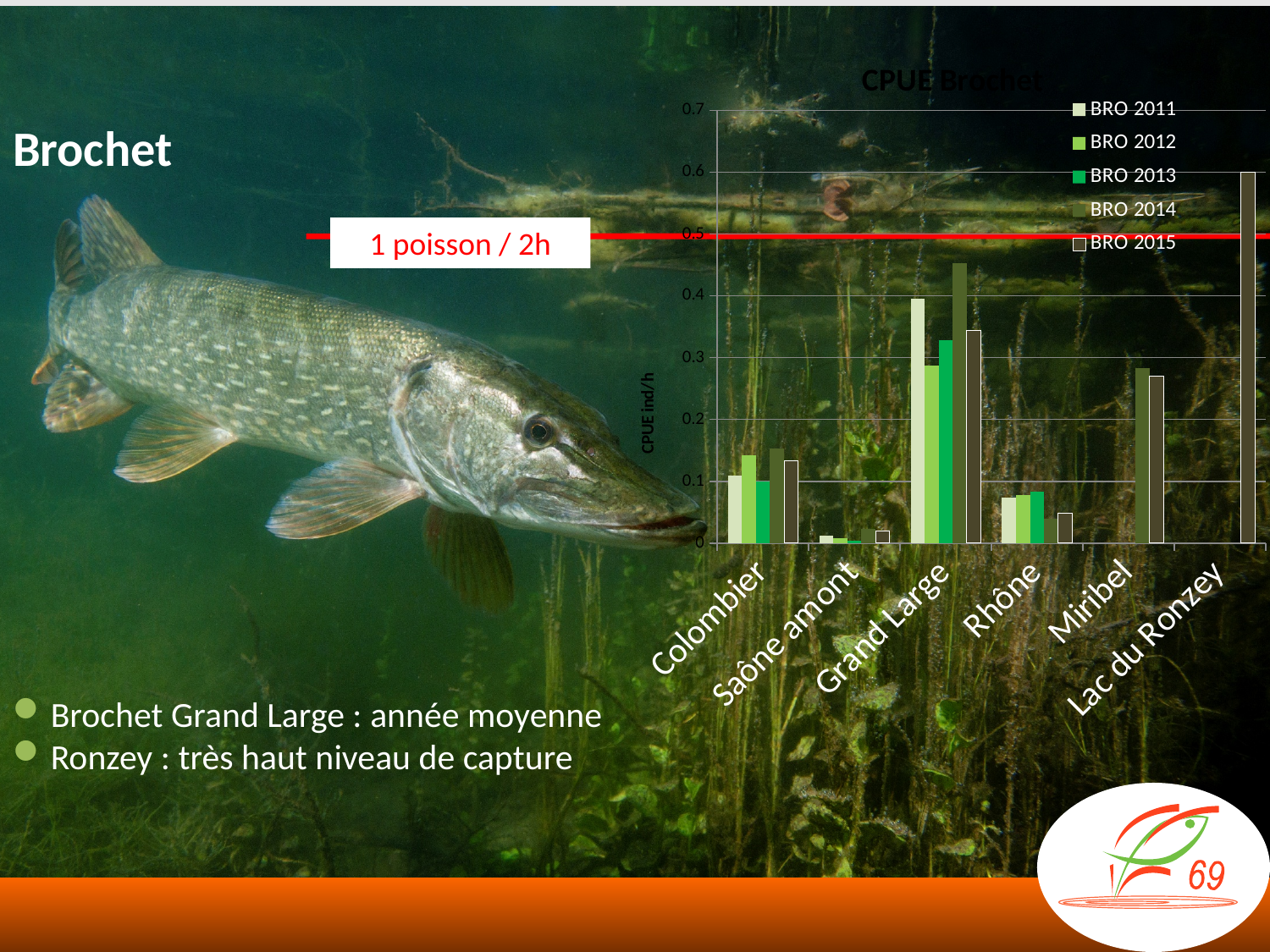
What label is written on the red horizontal line across the chart? 1 poisson / 2h Is the BRO 2015 value for Rhône greater or less than 0.1? less What kind of chart is shown on the slide? bar chart Which category has the lowest bars overall in the chart? Saône amont How many series does the legend list? 5 Which is larger, the BRO 2011 value for Grand Large or the BRO 2011 value for Colombier? Grand Large Which category has the tallest bar in the chart? Lac du Ronzey Is the BRO 2014 value for Miribel greater or less than 0.2? greater Is the BRO 2014 value for Grand Large greater or less than 0.4? greater What is the title of the chart? CPUE Brochet How many categories are shown on the x axis of the chart? 6